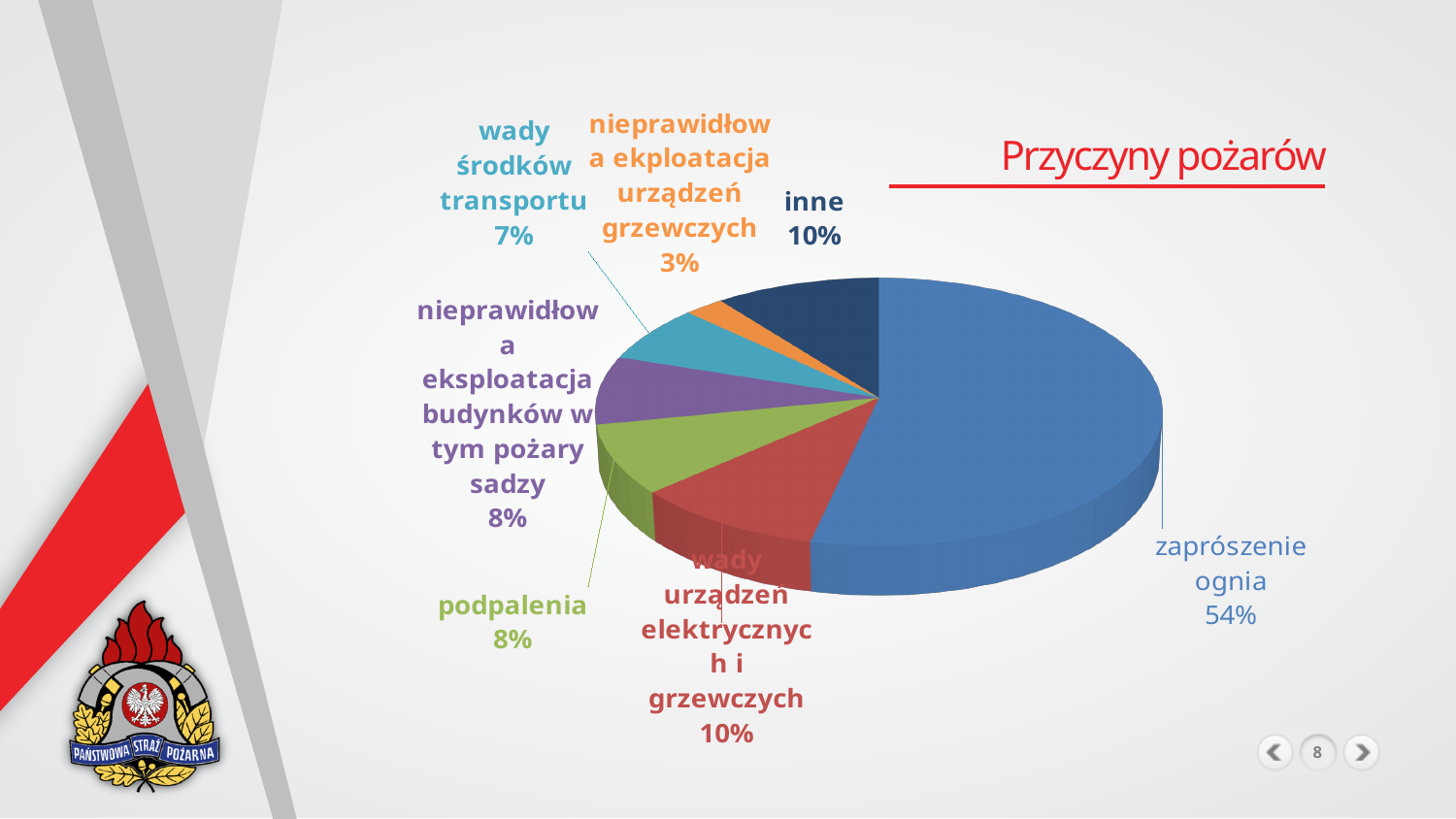
What percentage is shown for "inne"? 10% Which category has the smallest share of the pie? nieprawidłowa ekploatacja urządzeń grzewczych How many slices does the pie chart have? 7 What is the title of the chart? Przyczyny pożarów What percentage is shown for "nieprawidłowa ekploatacja urządzeń grzewczych"? 3% What share of the pie does "zaprószenie ognia" have? 54% What kind of chart is shown on the slide? pie chart What percentage is shown for "wady środków transportu"? 7% What percentage is shown for "podpalenia"? 8% Which is larger, the share for "wady środków transportu" or the share for "wady urządzeń elektrycznych i grzewczych"? wady urządzeń elektrycznych i grzewczych Which category has the largest share of the pie? zaprószenie ognia What is the difference in percentage points between "zaprószenie ognia" and "inne"? 44